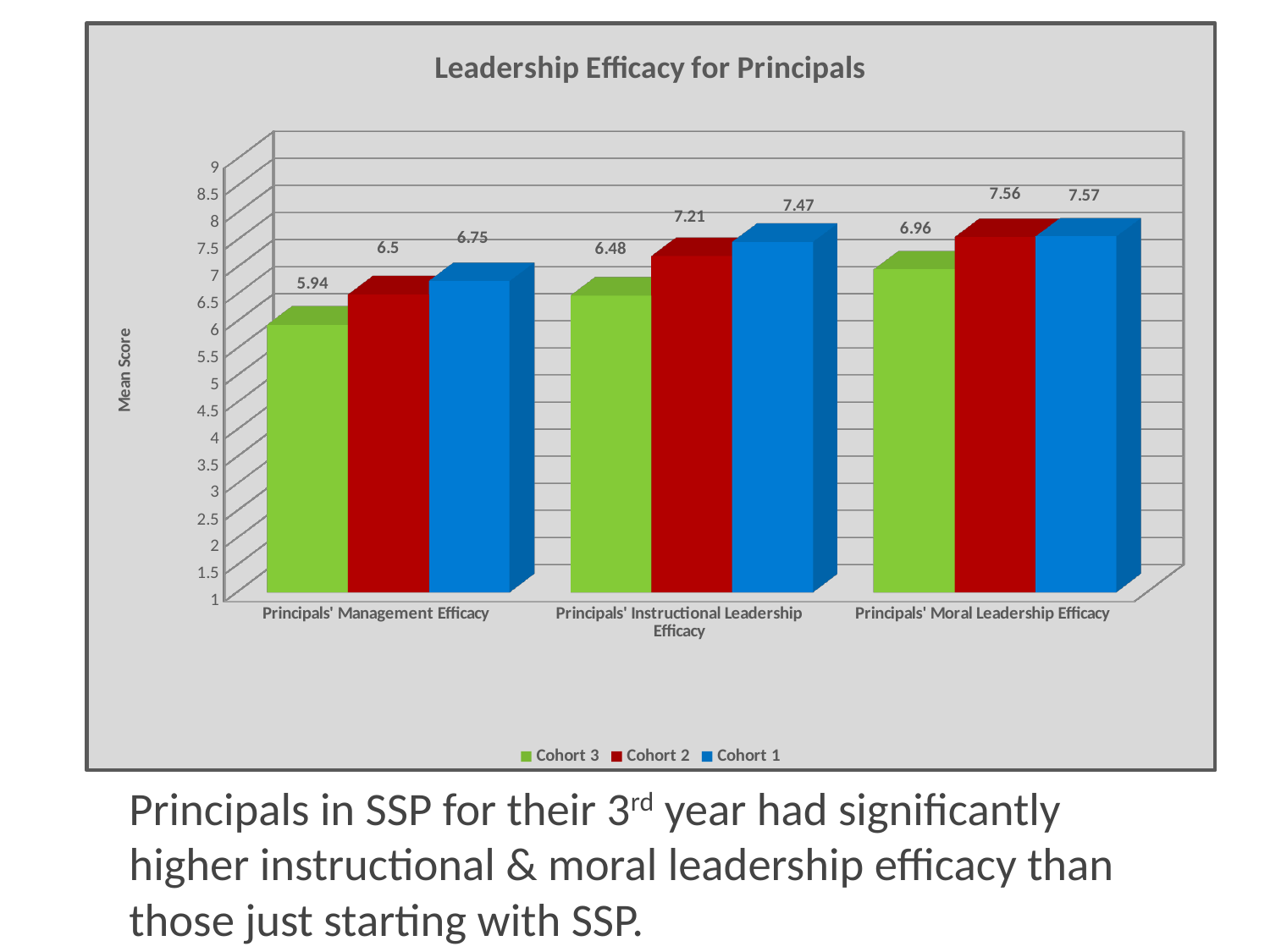
What is the mean score for Cohort 1 in Principals' Instructional Leadership Efficacy? 7.47 What is the mean score for Cohort 2 in Principals' Moral Leadership Efficacy? 7.56 Which cohort has the lowest mean score for Principals' Instructional Leadership Efficacy? Cohort 3 What is the title of the chart? Leadership Efficacy for Principals What is the mean score for Cohort 3 in Principals' Management Efficacy? 5.94 What is the difference between Cohort 1 and Cohort 3 mean scores for Principals' Management Efficacy? 0.81 How many categories are shown on the x axis? 3 Which category has the highest mean score for Cohort 3? Principals' Moral Leadership Efficacy Which is larger for Principals' Instructional Leadership Efficacy: the Cohort 2 score or the Cohort 3 score? Cohort 2 How many series does the legend list? 3 What type of chart is shown on the slide? Bar chart Which colour represents Cohort 1 in the chart? Blue